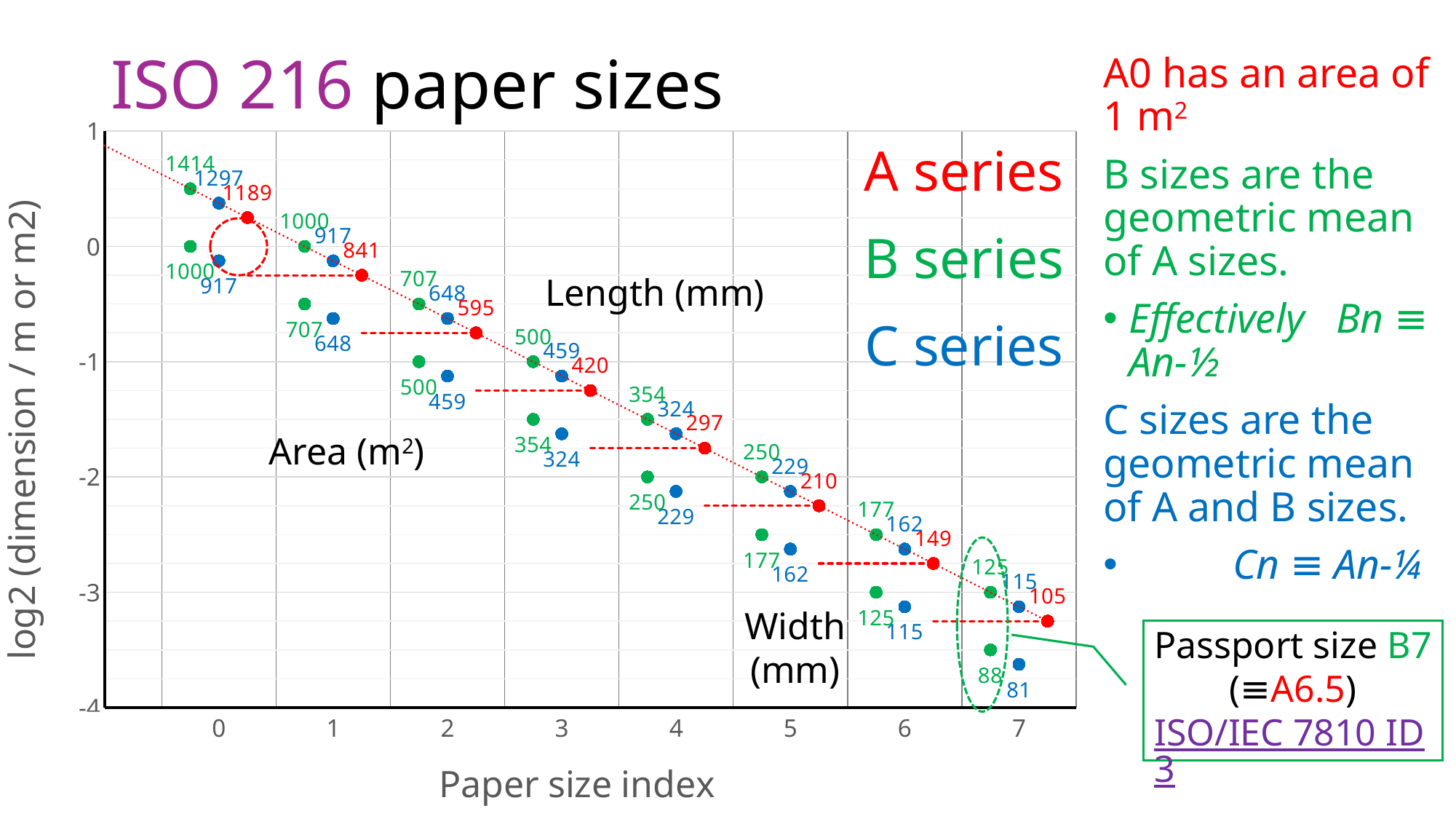
How many A series (red) points are plotted on the chart? 8 What is the A series length (mm) label at paper size index 0? 1189 At paper size index 3, which series has the larger length label: B series (500) or C series (459)? B series What is the B series width (mm) label at paper size index 7? 88 What is the C series width (mm) label at paper size index 7? 81 What is the title of the chart's x axis? Paper size index What is the B series length (mm) label at paper size index 0? 1414 What kind of chart is shown on the slide? scatter chart What is the A series length (mm) label at paper size index 7? 105 How many series does the chart's legend list? 3 What is the difference between the A series length labels at index 0 (1189) and index 1 (841)? 348 Do the plotted values rise or fall as the paper size index increases? fall